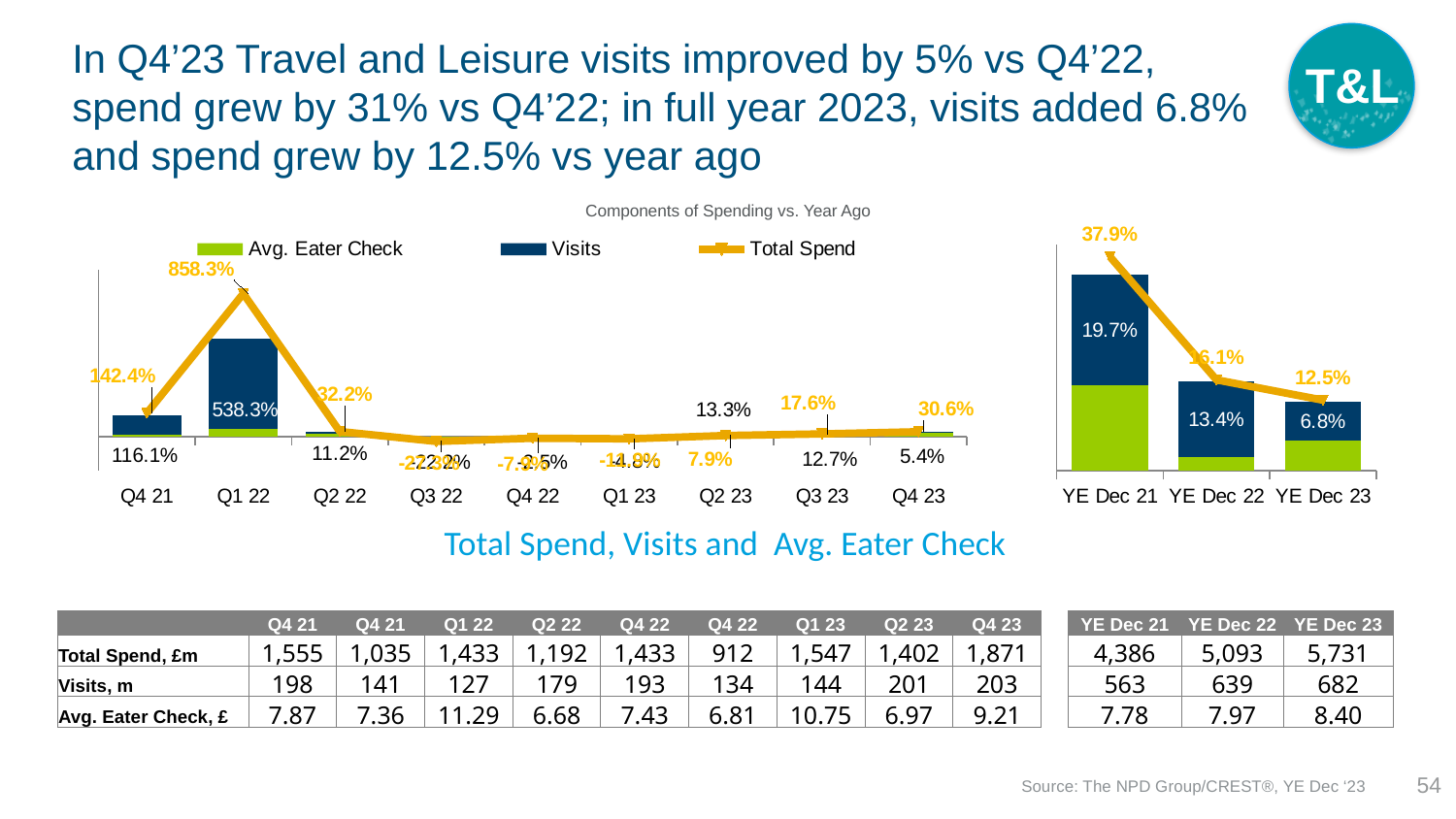
On the right chart (YE Dec 21 to YE Dec 23), what is the Total Spend value for YE Dec 21? 37.9% On the left chart (Components of Spending vs. Year Ago), what is the Total Spend value for Q1 22? 858.3% On the right chart (YE Dec 21 to YE Dec 23), what is the Visits value for YE Dec 23? 6.8% On the left chart (Components of Spending vs. Year Ago), what is the Total Spend value for Q4 23? 30.6% On the left chart (Components of Spending vs. Year Ago), how many series does the legend list? 3 On the left chart (Components of Spending vs. Year Ago), what is the difference between the Total Spend values for Q4 23 and Q3 23? 13.0 percentage points On the right chart (YE Dec 21 to YE Dec 23), does the Total Spend line rise or fall from YE Dec 21 to YE Dec 23? fall On the left chart (Components of Spending vs. Year Ago), how many quarters are shown on the x axis? 9 On the left chart (Components of Spending vs. Year Ago), what is the Visits value for Q3 23? 12.7% On the left chart (Components of Spending vs. Year Ago), what is the Visits value for Q1 22? 538.3% On the left chart (Components of Spending vs. Year Ago), which quarter has the highest Total Spend value? Q1 22 On the left chart (Components of Spending vs. Year Ago), which is larger: the Total Spend value for Q4 23 or for Q3 23? Q4 23